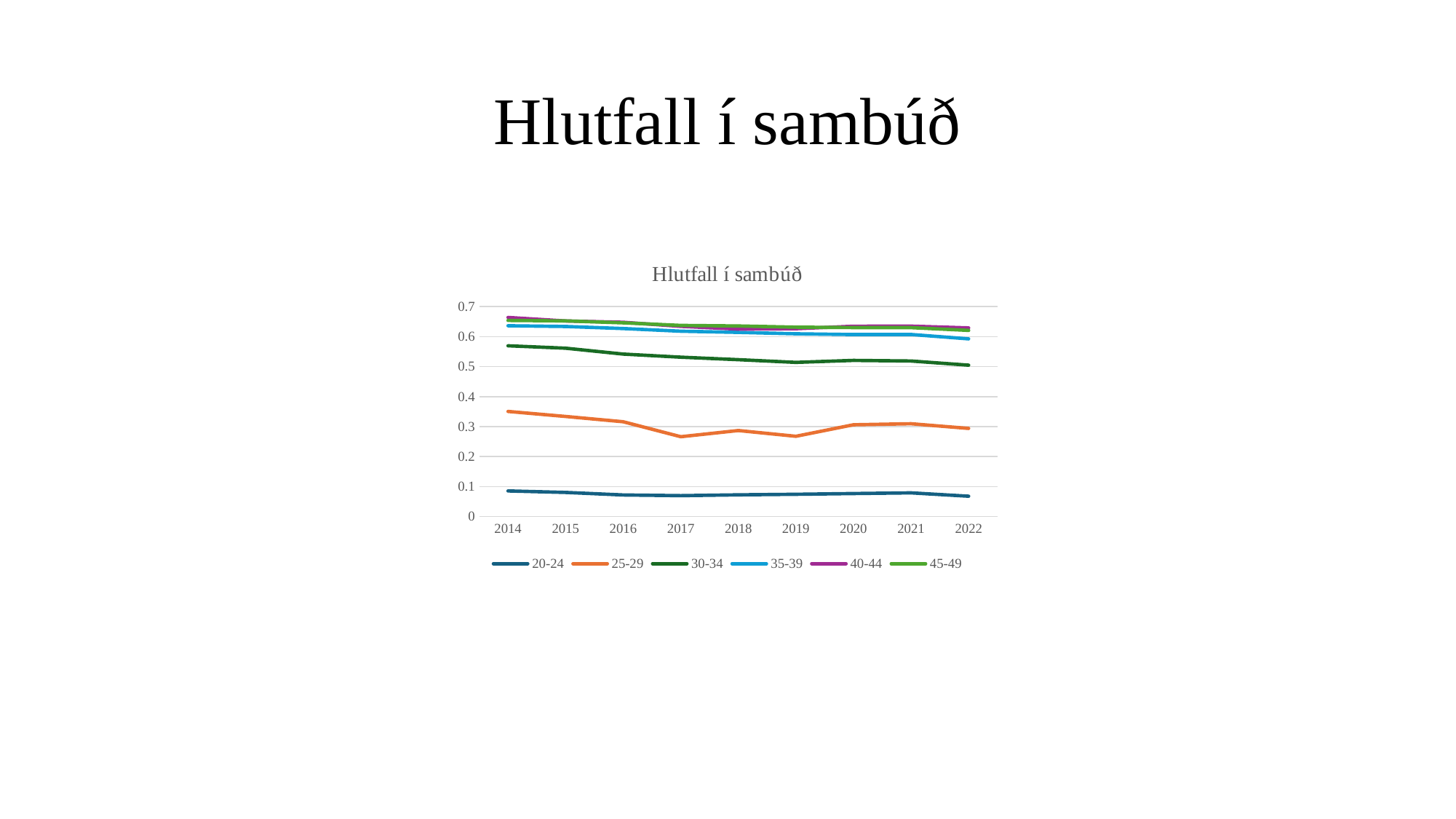
In 2018, which is larger: the value for 30-34 or the value for 25-29? 30-34 How many series does the legend list? 6 Is the value for 30-34 in 2014 greater or less than 0.5? greater What is the title of the chart? Hlutfall í sambúð Is the value for 25-29 in 2017 greater or less than 0.3? less Which age group series has the lowest values across all years? 20-24 Is the value for 25-29 in 2014 greater or less than 0.3? greater What kind of chart is shown on the slide? line chart Which series is drawn in orange in the legend? 25-29 How many years are shown along the x axis? 9 Does the 30-34 series rise or fall from 2014 to 2022? fall